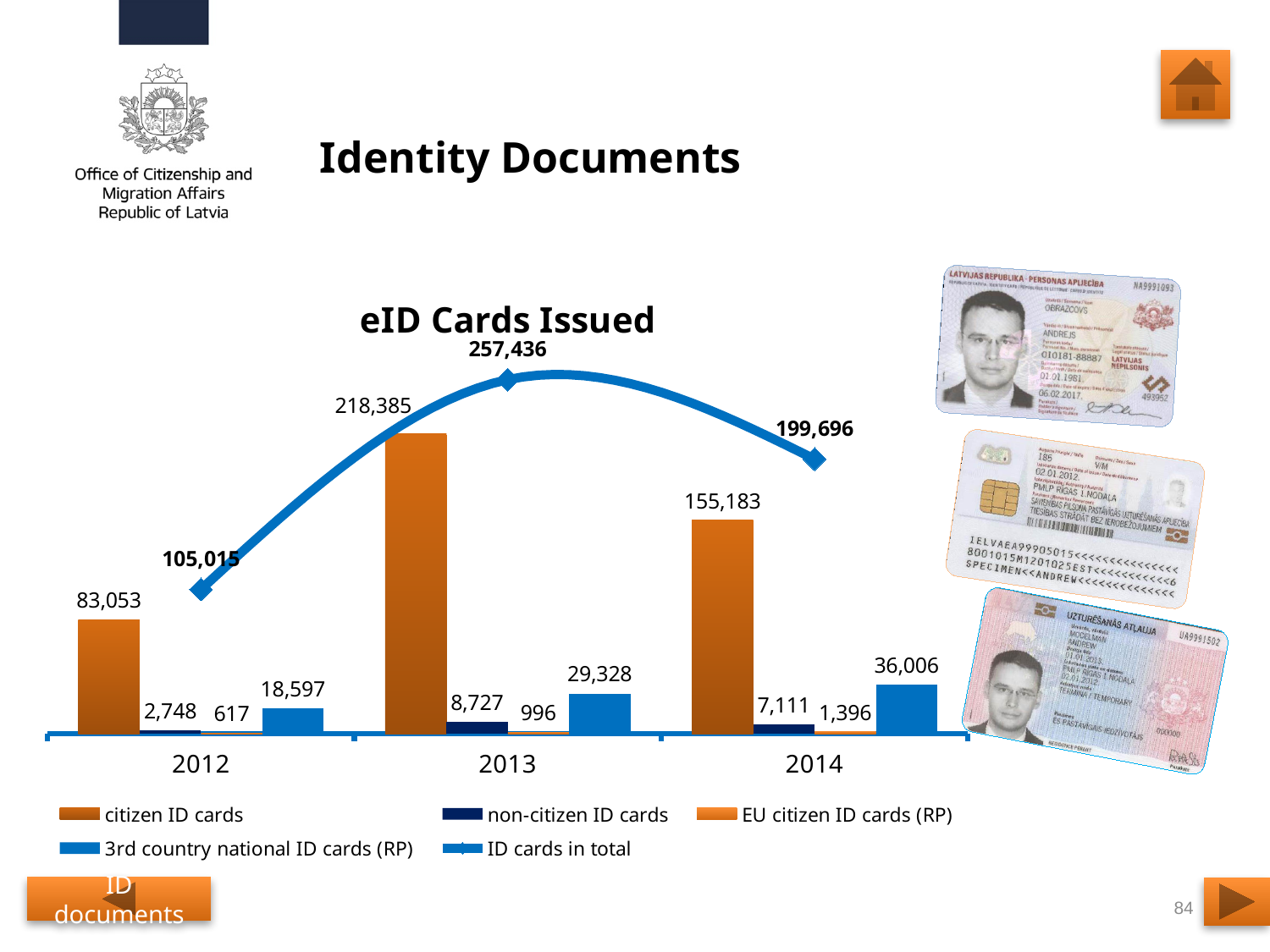
What is the value for citizen ID cards in 2013? 218,385 Which is larger: 3rd country national ID cards (RP) in 2014 or in 2013? 2014 What is the difference between citizen ID cards in 2013 and in 2014? 63,202 In which year was the value for non-citizen ID cards lowest? 2012 How many series does the legend list? 5 What is the value for EU citizen ID cards (RP) in 2014? 1,396 How many years are shown on the x axis? 3 In which year was the ID cards in total value highest? 2013 How many 3rd country national ID cards (RP) were issued in 2012? 18,597 What is the value of ID cards in total for 2014? 199,696 What is the title of the chart? eID Cards Issued What kind of chart is used for the ID cards in total series? line chart